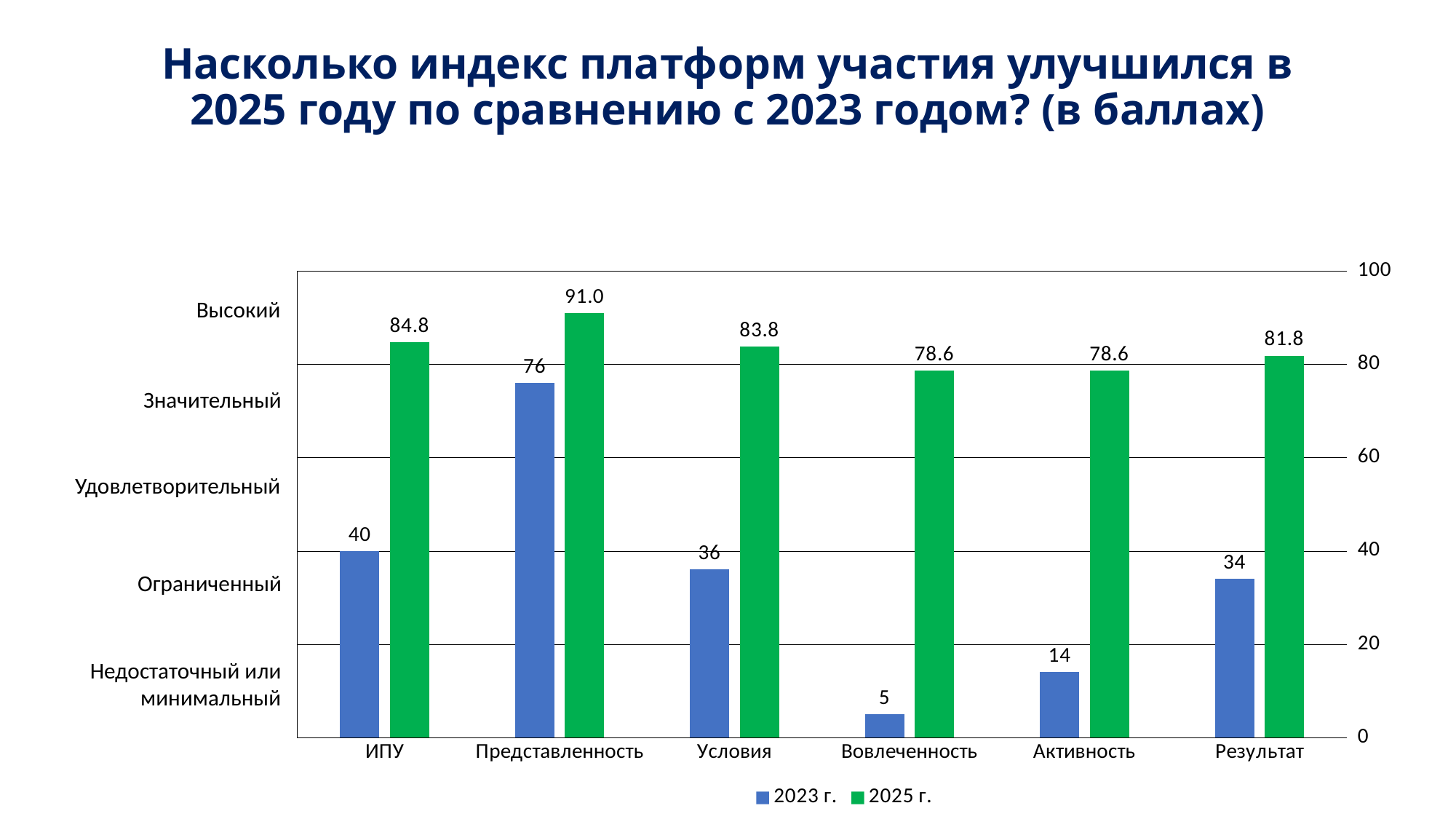
Which category has the lowest 2023 г. value? Вовлеченность What is the difference between the 2025 г. and 2023 г. values for Условия? 47.8 Which is larger: the 2023 г. value for Представленность or the 2023 г. value for Активность? Представленность How many series does the legend list? 2 What is the 2025 г. value for Представленность? 91.0 What is the 2023 г. value for ИПУ? 40 What kind of chart is shown on the slide? Bar chart What is the 2023 г. value for Вовлеченность? 5 What is the 2025 г. value for Результат? 81.8 Which category has the highest 2025 г. value? Представленность How many categories are shown on the x axis? 6 Which colour represents the 2025 г. series? Green